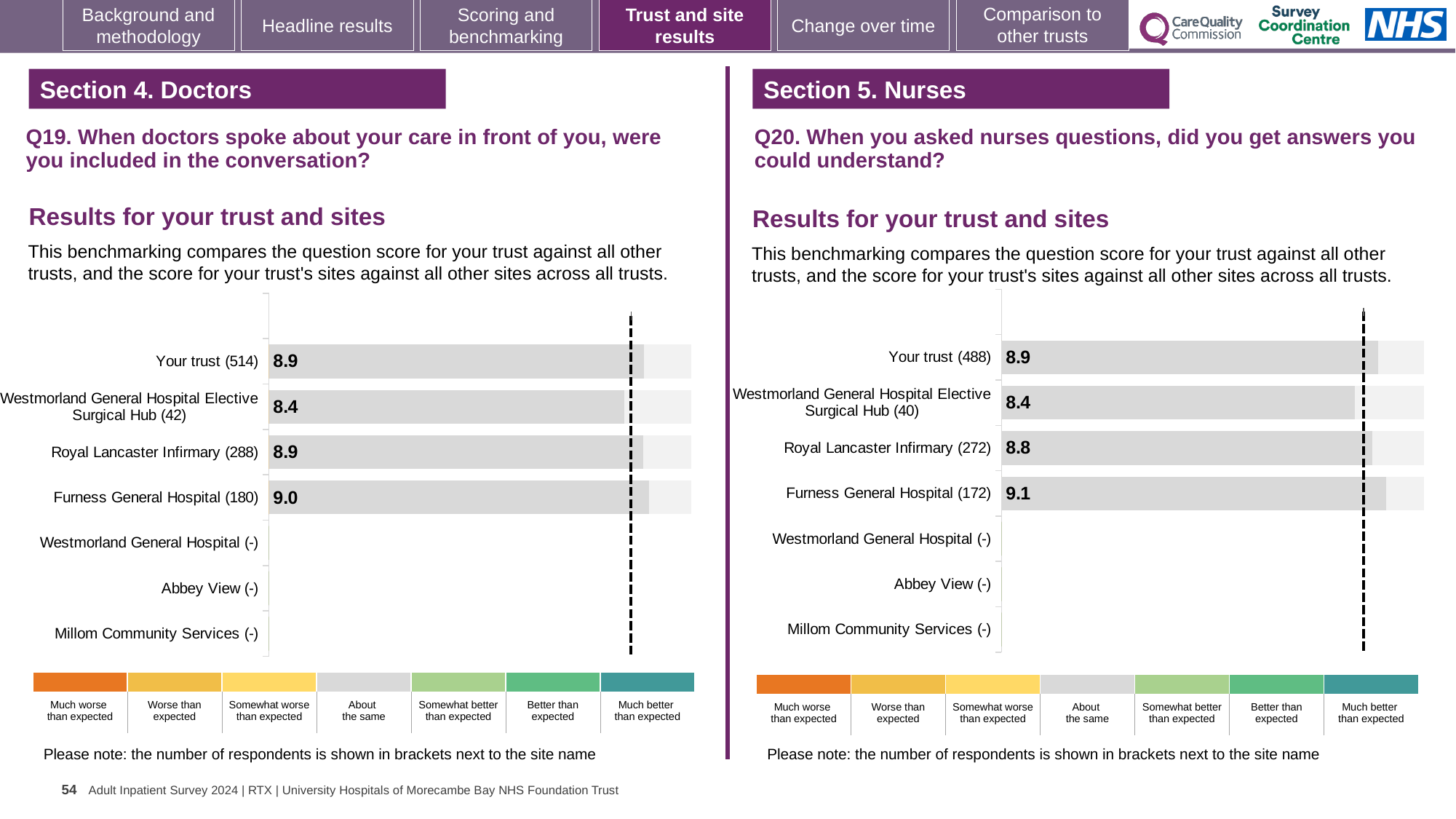
How many sites or rows are listed in the Q19 chart on the left? 7 In the Q20 chart on the right, how many respondents are shown for Your trust? 488 In the Q20 chart on the right, what is the score for Royal Lancaster Infirmary? 8.8 In the Q20 chart on the right, which site has the highest score? Furness General Hospital In the Q19 chart on the left, how many respondents are shown for Royal Lancaster Infirmary? 288 In the Q20 chart on the right, what is the difference between the scores for Furness General Hospital and Your trust? 0.2 In the Q19 chart on the left, what is the difference between the scores for Furness General Hospital and Westmorland General Hospital Elective Surgical Hub? 0.6 What kind of chart is used for the Q20 results on the right? Bar chart In the Q20 chart on the right, which is larger: the score for Your trust or the score for Royal Lancaster Infirmary? Your trust In the Q19 chart on the left, what is the score for Your trust? 8.9 In the Q19 chart on the left, which site has the lowest score? Westmorland General Hospital Elective Surgical Hub In the Q19 chart on the left, what is the score for Furness General Hospital? 9.0